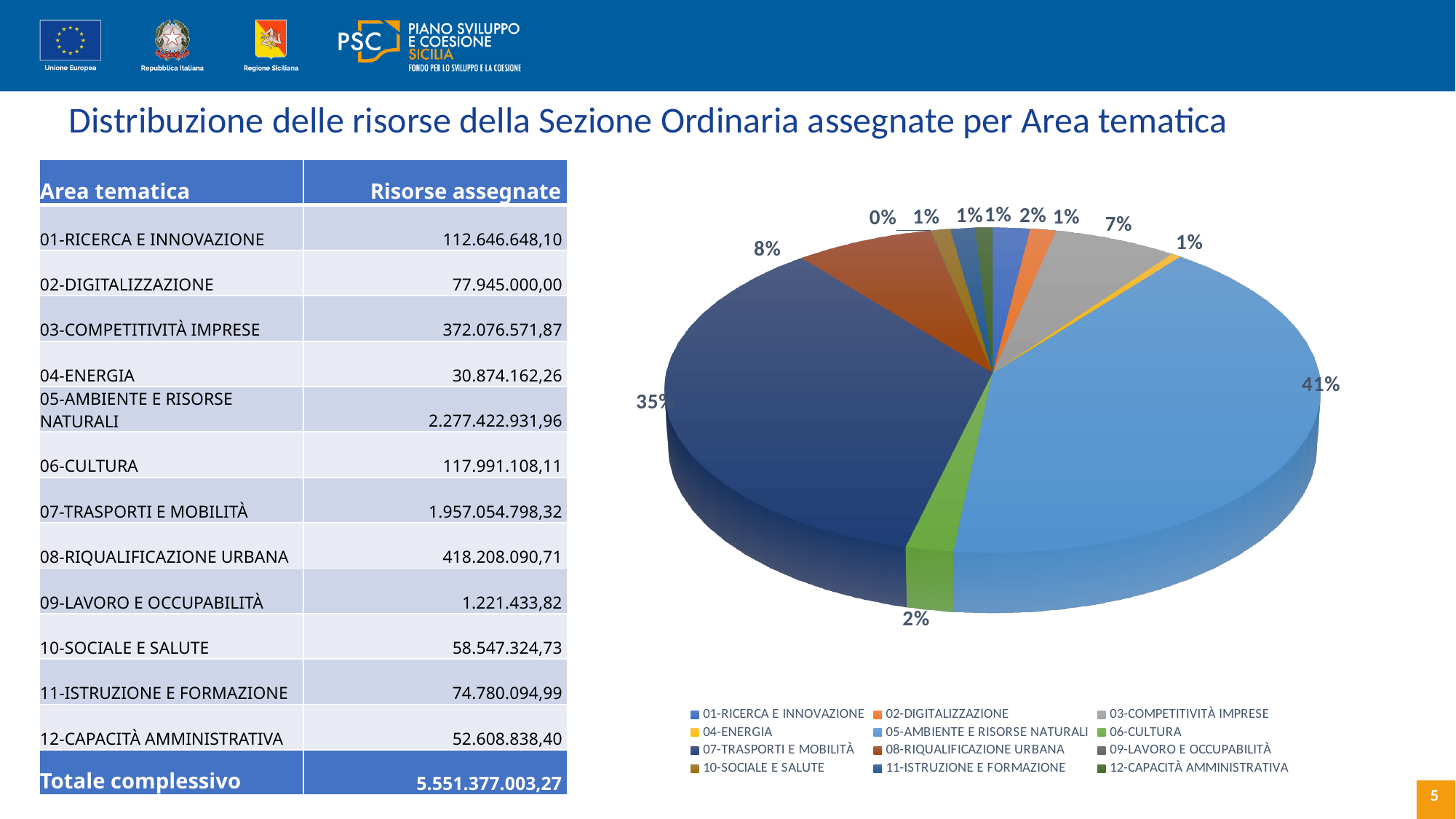
What colour is the 05-AMBIENTE E RISORSE NATURALI slice in the pie chart? light blue What percentage is shown for the 03-COMPETITIVITÀ IMPRESE slice? 7% What percentage is shown for the 08-RIQUALIFICAZIONE URBANA slice? 8% Which area tematica has the smallest slice of the pie, labelled 0%? 09-LAVORO E OCCUPABILITÀ What share of the pie does 05-AMBIENTE E RISORSE NATURALI represent? 41% What kind of chart is shown on the slide? pie chart How many entries does the legend of the pie chart list? 12 Which area tematica has the largest slice of the pie? 05-AMBIENTE E RISORSE NATURALI Which slice is larger: 05-AMBIENTE E RISORSE NATURALI or 07-TRASPORTI E MOBILITÀ? 05-AMBIENTE E RISORSE NATURALI By how many percentage points does the 05-AMBIENTE E RISORSE NATURALI slice exceed the 07-TRASPORTI E MOBILITÀ slice? 6 percentage points